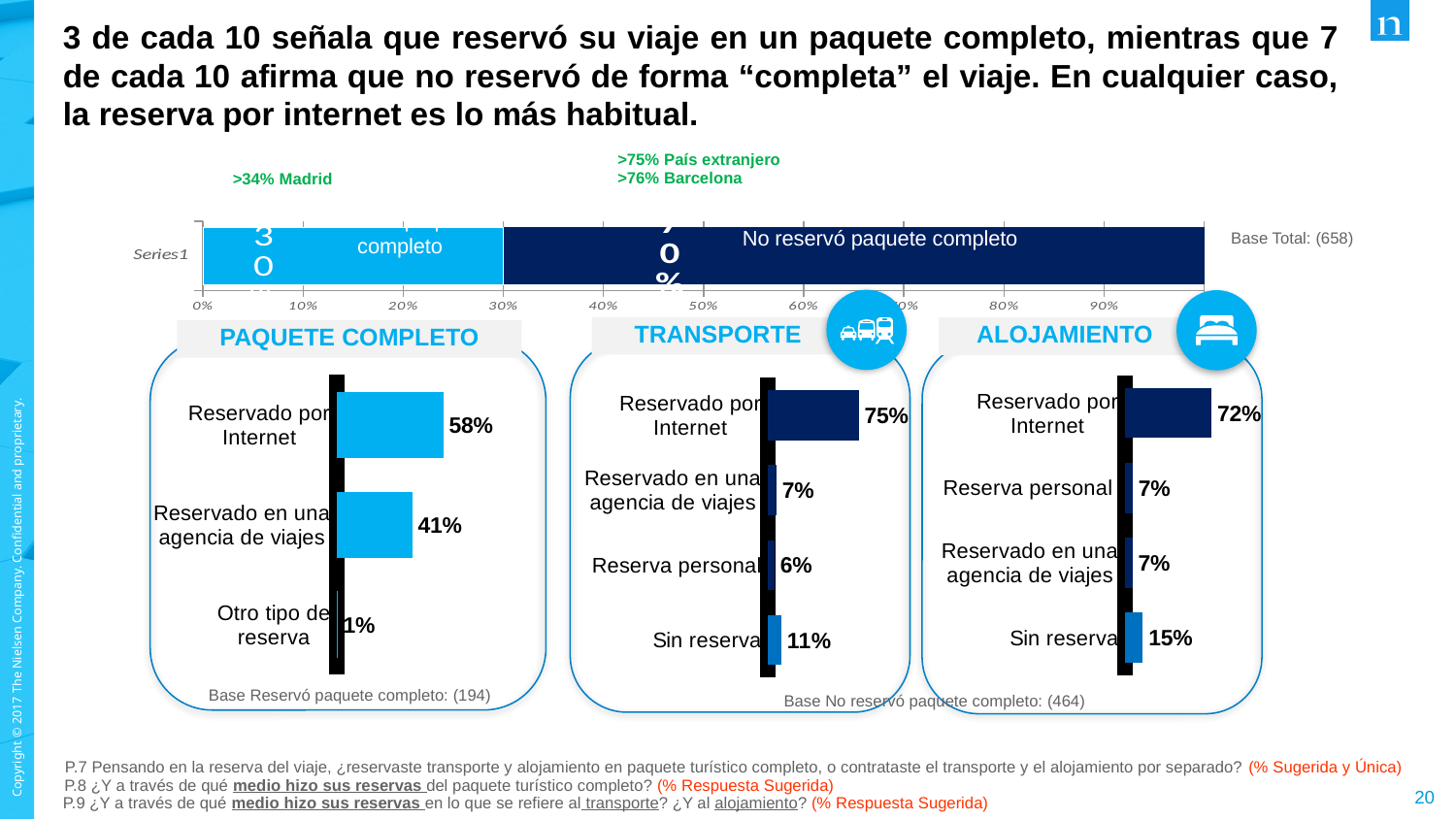
Which is larger: Reservado por Internet in the TRANSPORTE chart or Reservado por Internet in the ALOJAMIENTO chart? TRANSPORTE (75%) In the TRANSPORTE chart, what is the value for Sin reserva? 11% In the TRANSPORTE chart, what is the value for Reservado por Internet? 75% In the PAQUETE COMPLETO chart, what is the value for Reservado por Internet? 58% In the PAQUETE COMPLETO chart, which category has the lowest value? Otro tipo de reserva In the PAQUETE COMPLETO chart, what is the value for Reservado en una agencia de viajes? 41% In the TRANSPORTE chart, which category has the lowest value? Reserva personal In the ALOJAMIENTO chart, what is the value for Sin reserva? 15% What kind of chart is the PAQUETE COMPLETO chart? Bar chart In the ALOJAMIENTO chart, which category has the highest value? Reservado por Internet In the PAQUETE COMPLETO chart, what is the difference between Reservado por Internet and Reservado en una agencia de viajes? 17 percentage points In the TRANSPORTE chart, how many categories are shown? 4